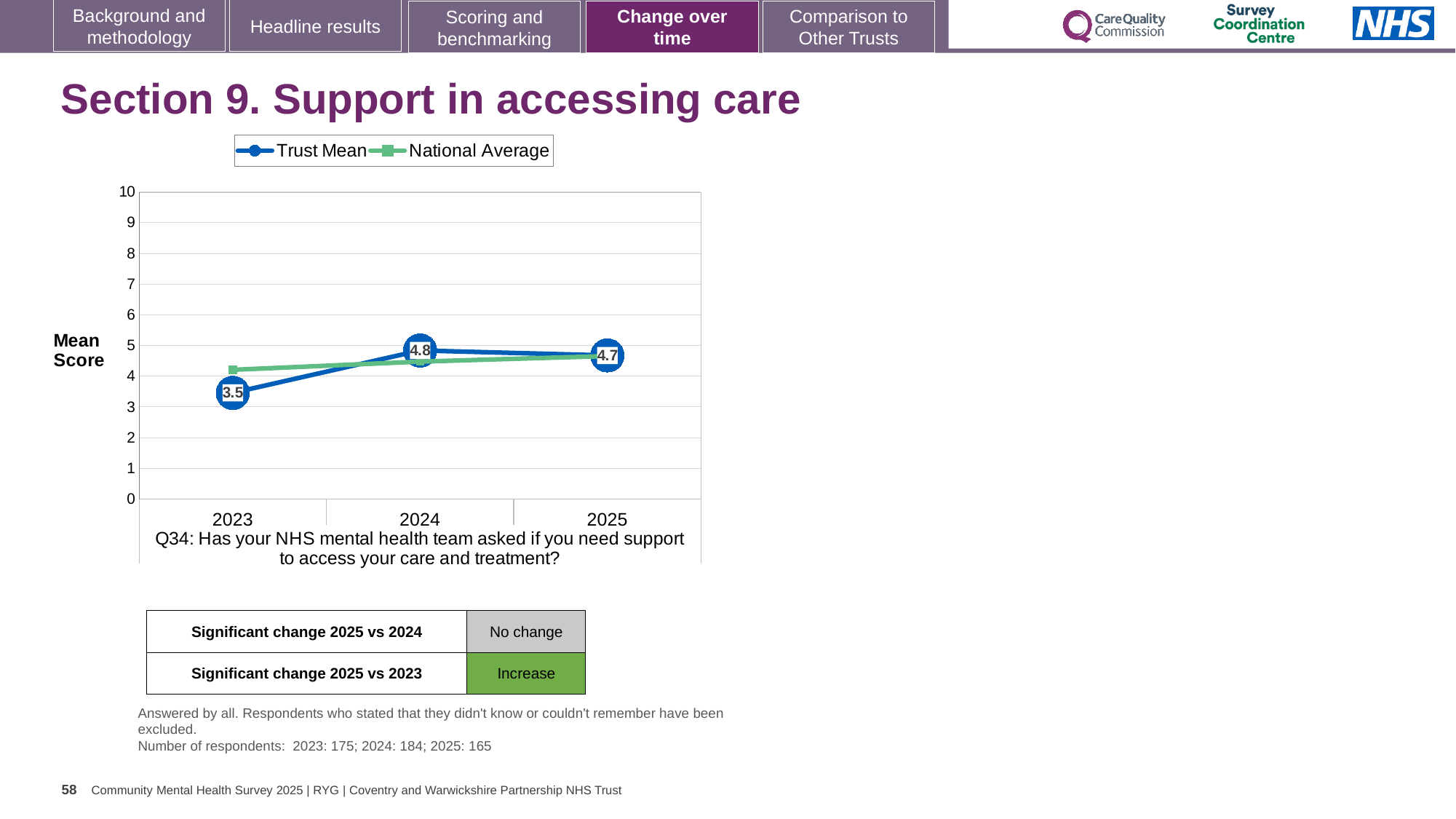
Does the Trust Mean rise or fall from 2023 to 2024? rise What kind of chart is shown on the slide? line chart In which year is the Trust Mean lowest? 2023 How many years are plotted on the x axis? 3 How many series does the legend list? 2 What is the Trust Mean value for 2024? 4.8 Is the National Average value for 2025 greater or less than 5? less In which year is the Trust Mean highest? 2024 What is the Trust Mean value for 2025? 4.7 What is the Trust Mean value for 2023? 3.5 In 2023, which is larger: the Trust Mean or the National Average? National Average What is the difference between the Trust Mean in 2024 and in 2023? 1.3